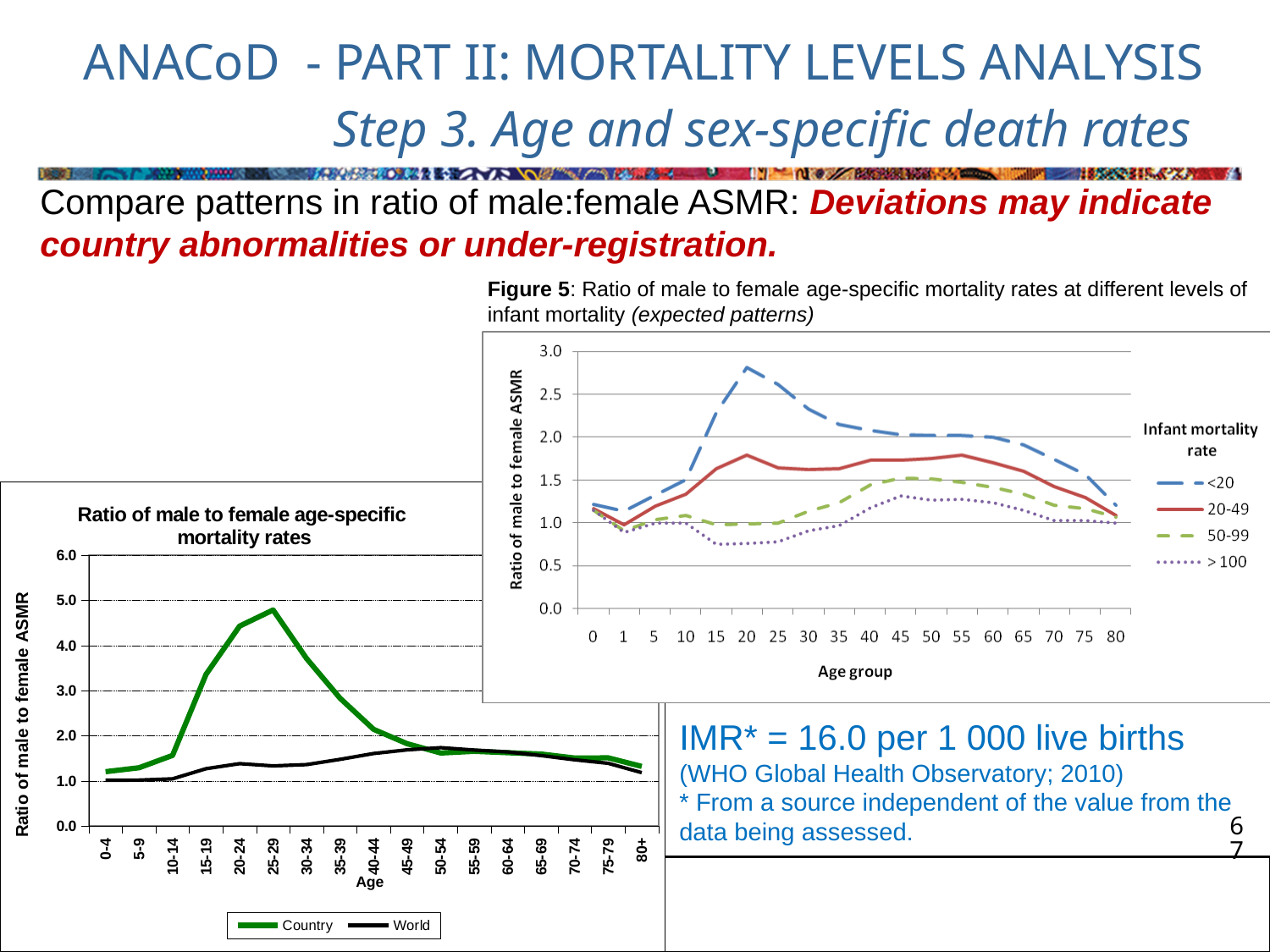
In the Figure 5 chart, is the value of the >100 series at age group 20 greater or less than 1.0? less In the left chart 'Ratio of male to female age-specific mortality rates', which series is higher at age 20-24, Country or World? Country In the Figure 5 chart, which infant mortality rate series has the highest ratio at age group 20? <20 What kind of chart is the left chart titled 'Ratio of male to female age-specific mortality rates'? line chart In the left chart 'Ratio of male to female age-specific mortality rates', does the Country series rise or fall between age 25-29 and age 45-49? fall In the left chart 'Ratio of male to female age-specific mortality rates', at which age group does the Country series reach its highest value? 25-29 In the left chart 'Ratio of male to female age-specific mortality rates', how many age groups are shown on the x axis? 17 In the left chart 'Ratio of male to female age-specific mortality rates', how many series does the legend list? 2 In the left chart 'Ratio of male to female age-specific mortality rates', is the World value for age 20-24 greater or less than 2.0? less In the Figure 5 chart, is the value of the <20 series at age group 20 greater or less than 2.5? greater In the Figure 5 chart, how many infant mortality rate series does the legend list? 4